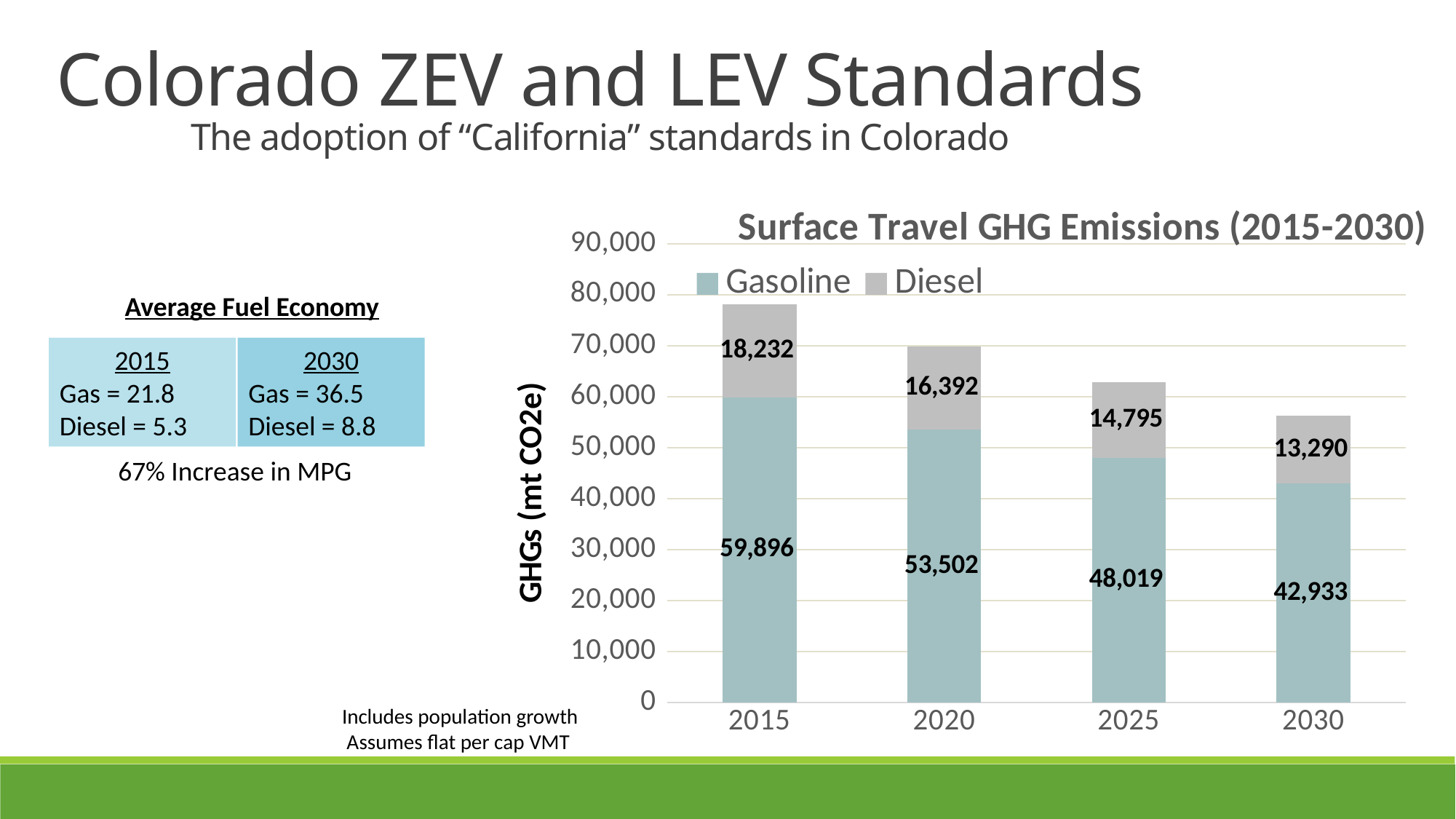
What is the difference between the Gasoline values for 2015 and 2030 in the Surface Travel GHG Emissions chart? 16,963 How many series does the legend of the Surface Travel GHG Emissions chart list? 2 What is the Diesel value for 2030 in the Surface Travel GHG Emissions chart? 13,290 What is the total of the stacked bar for 2030 in the Surface Travel GHG Emissions chart? 56,223 Is the Gasoline value for 2020 larger or smaller than the Gasoline value for 2025 in the Surface Travel GHG Emissions chart? larger What is the Gasoline value for 2015 in the Surface Travel GHG Emissions chart? 59,896 What is the total of the stacked bar for 2015 in the Surface Travel GHG Emissions chart? 78,128 Which year has the lowest Diesel emissions in the Surface Travel GHG Emissions chart? 2030 How many years are shown on the x axis of the Surface Travel GHG Emissions chart? 4 What is the difference between the Diesel values for 2015 and 2020 in the Surface Travel GHG Emissions chart? 1,840 Which year has the highest Gasoline emissions in the Surface Travel GHG Emissions chart? 2015 What is the Gasoline value for 2025 in the Surface Travel GHG Emissions chart? 48,019